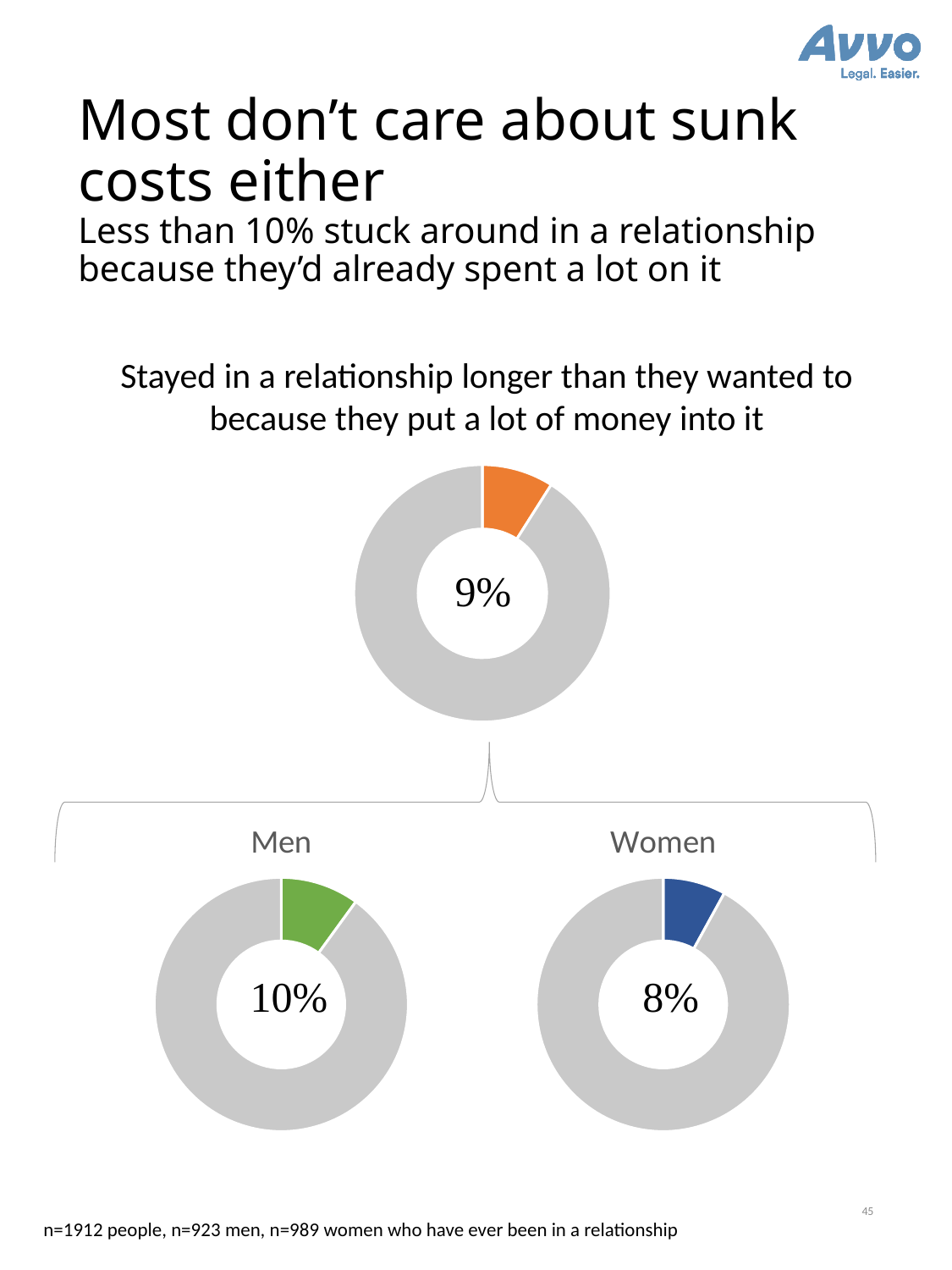
What kind of chart is used to show the 9% figure at the top of the slide? Donut (pie) chart Is the value in the Men donut chart greater or less than the value in the overall (top) donut chart? greater In the top donut chart, what percentage stayed in a relationship longer than they wanted to because they put a lot of money into it? 9% Which of the three donut charts shows the lowest percentage? Women In the Women donut chart, what percentage stayed in a relationship longer because they put a lot of money into it? 8% In the Men donut chart, what percentage stayed in a relationship longer because they put a lot of money into it? 10% Comparing the Men and Women donut charts, which group has the higher percentage? Men What is the difference between the Men percentage and the Women percentage shown in the bottom donut charts? 2% How many donut charts are shown on the slide? 3 What colour is the highlighted slice in the Men donut chart? Green What colour is the highlighted slice in the top (overall) donut chart? Orange Is the value in the Women donut chart greater or less than the value in the overall (top) donut chart? less